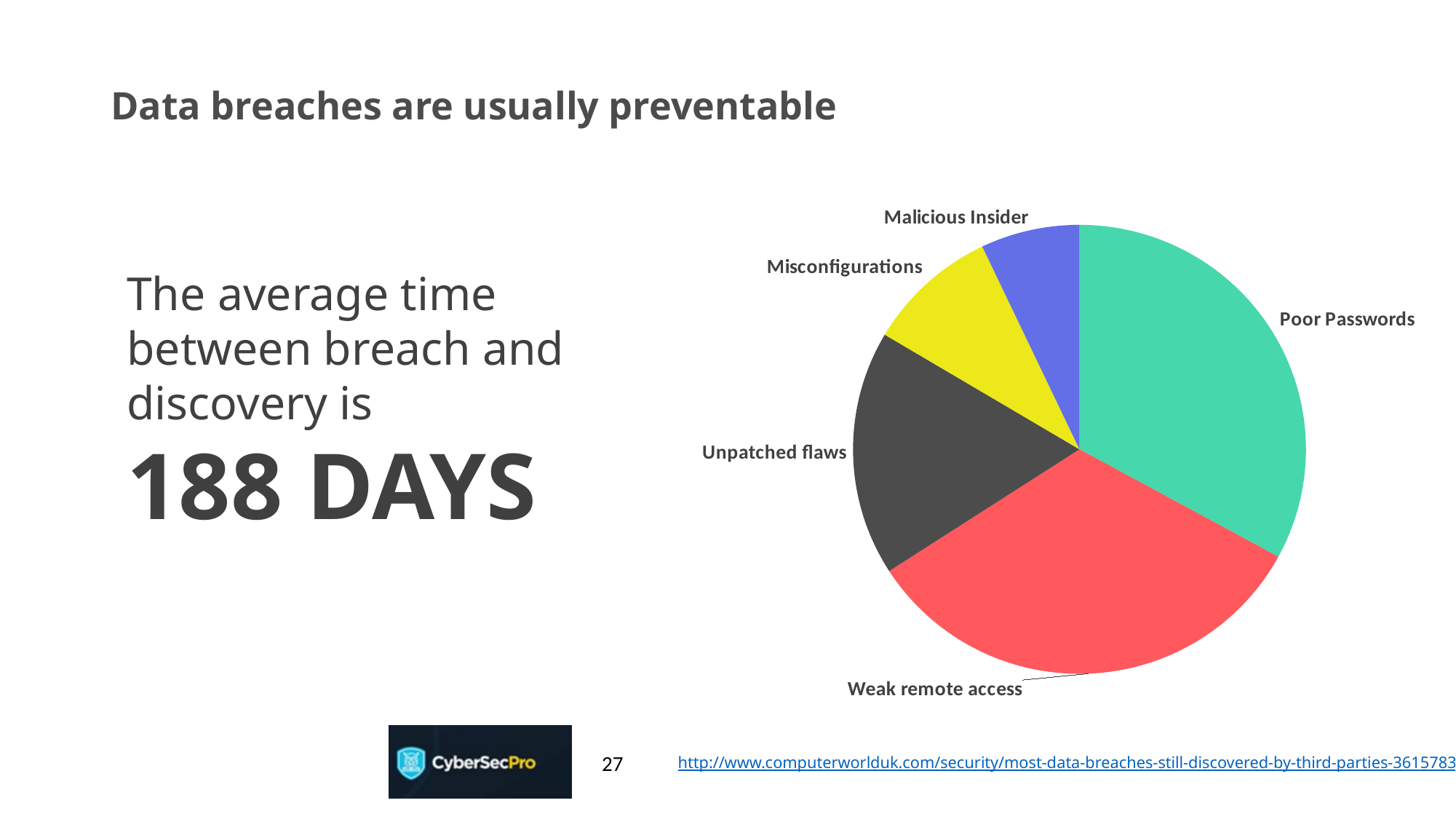
Which is larger in the pie chart, Weak remote access or Malicious Insider? Weak remote access Which slice of the pie chart is the smallest? Malicious Insider What kind of chart is shown on the slide? pie chart Which is larger in the pie chart, Misconfigurations or Weak remote access? Weak remote access How many slices does the pie chart have? 5 Which is larger in the pie chart, Poor Passwords or Unpatched flaws? Poor Passwords What colour is the Poor Passwords slice in the pie chart? teal (green) Which slice of the pie chart is coloured yellow? Misconfigurations